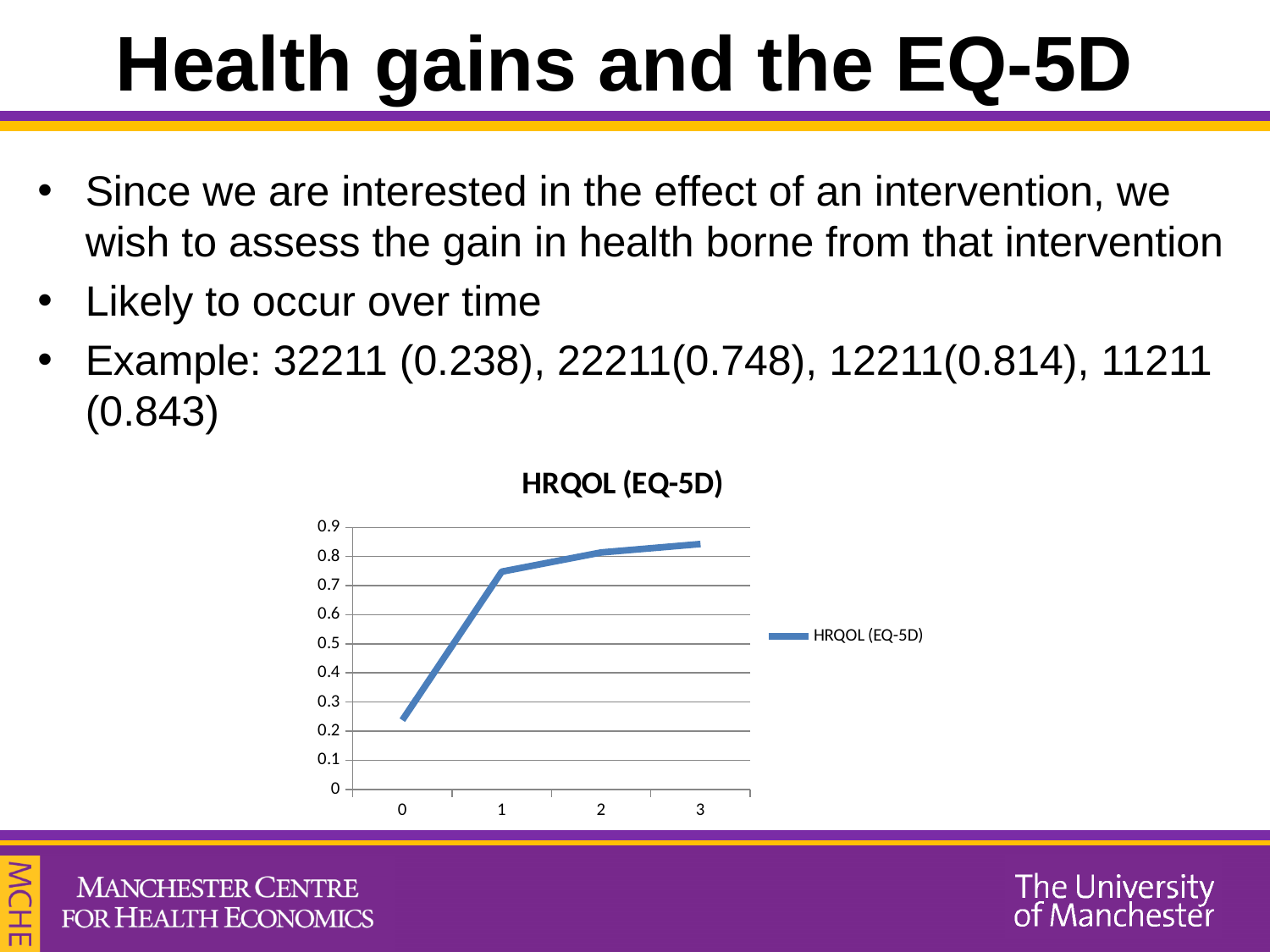
What is the name of the series shown in the legend? HRQOL (EQ-5D) What is the title of the chart? HRQOL (EQ-5D) At which x value is the HRQOL (EQ-5D) value lowest? 0 At which x value is the HRQOL (EQ-5D) value highest? 3 How many points are plotted on the line? 4 Is the HRQOL (EQ-5D) value at x = 0 greater or less than 0.3? less What kind of chart is shown on the slide? line chart How many series does the legend list? 1 Which has the larger HRQOL (EQ-5D) value, x = 0 or x = 1? 1 Do the HRQOL (EQ-5D) values rise or fall as x increases from 0 to 3? rise Is the HRQOL (EQ-5D) value at x = 1 greater or less than 0.7? greater Is the HRQOL (EQ-5D) value at x = 3 greater or less than 0.8? greater